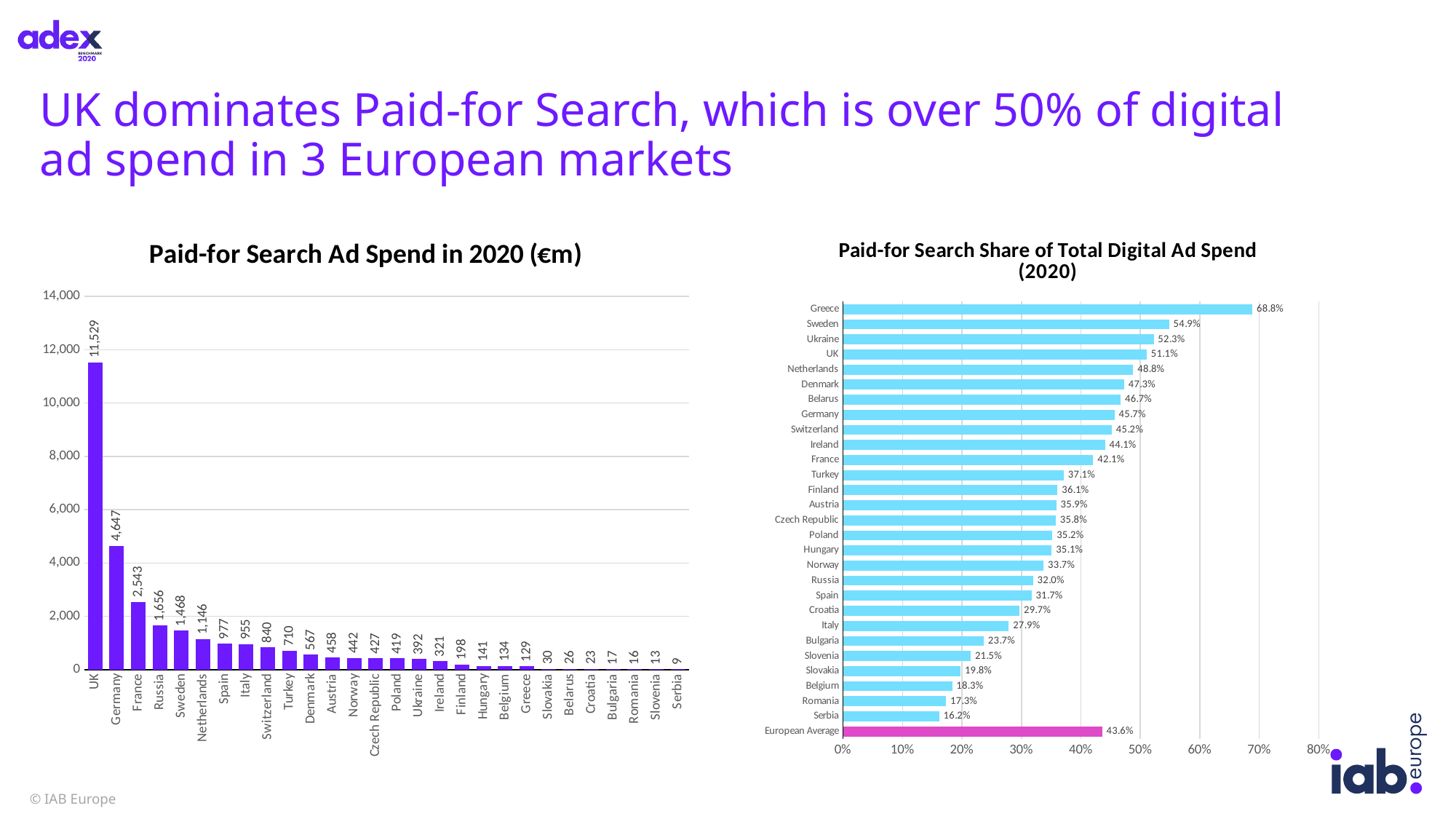
In the 'Paid-for Search Share of Total Digital Ad Spend (2020)' chart, how many bars are shown, including the European Average? 29 In the 'Paid-for Search Ad Spend in 2020 (€m)' chart, what is the difference between the values for UK and Germany? 6,882 In the 'Paid-for Search Ad Spend in 2020 (€m)' chart, which country has the highest value? UK In the 'Paid-for Search Share of Total Digital Ad Spend (2020)' chart, which country has the highest share? Greece In the 'Paid-for Search Share of Total Digital Ad Spend (2020)' chart, what is the value for the Netherlands? 48.8% In the 'Paid-for Search Ad Spend in 2020 (€m)' chart, how many countries are shown? 28 In the 'Paid-for Search Ad Spend in 2020 (€m)' chart, which country has the lowest value? Serbia In the 'Paid-for Search Share of Total Digital Ad Spend (2020)' chart, which is larger, the share for Turkey or the share for Finland? Turkey In the 'Paid-for Search Share of Total Digital Ad Spend (2020)' chart, what is the value for European Average? 43.6% What kind of chart is the 'Paid-for Search Ad Spend in 2020 (€m)' chart? Bar chart In the 'Paid-for Search Ad Spend in 2020 (€m)' chart, what is the value for Germany? 4,647 In the 'Paid-for Search Ad Spend in 2020 (€m)' chart, do the values rise or fall from left to right? Fall